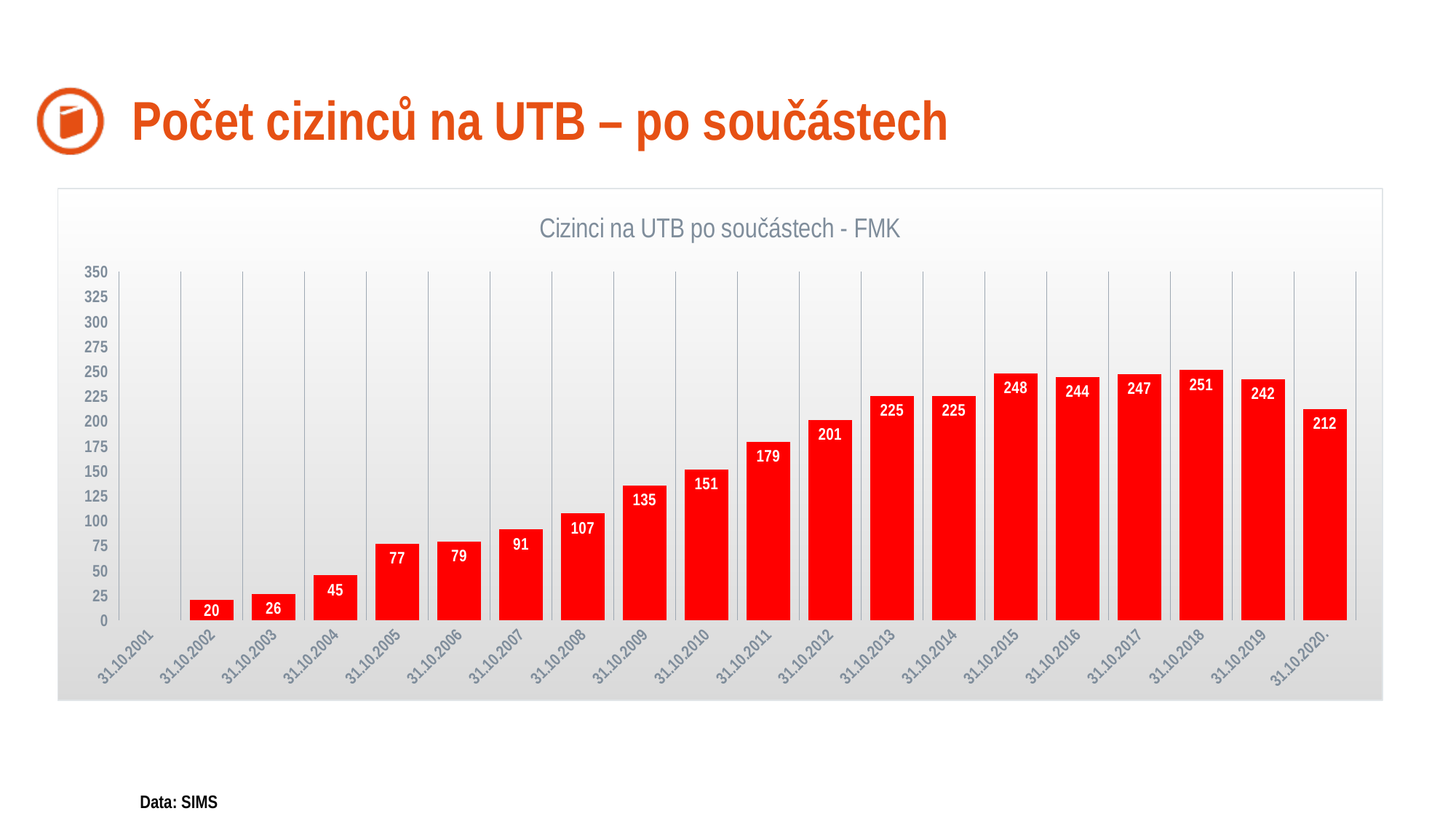
What type of chart is shown on the slide? bar chart Do the values generally rise or fall from 31.10.2002 to 31.10.2013? rise What is the title of the chart? Cizinci na UTB po součástech - FMK How many dates are shown on the x axis of the chart? 20 What is the difference between the values for 31.10.2012 and 31.10.2011? 22 Which date has the highest value in the chart? 31.10.2018 What is the value for 31.10.2005 in the chart? 77 What is the value for 31.10.2010 in the chart? 151 Is the value for 31.10.2009 greater or less than 125? greater Which is larger, the value for 31.10.2016 or the value for 31.10.2019? 31.10.2016 What is the value for 31.10.2020 in the chart? 212 What is the difference between the values for 31.10.2018 and 31.10.2020? 39